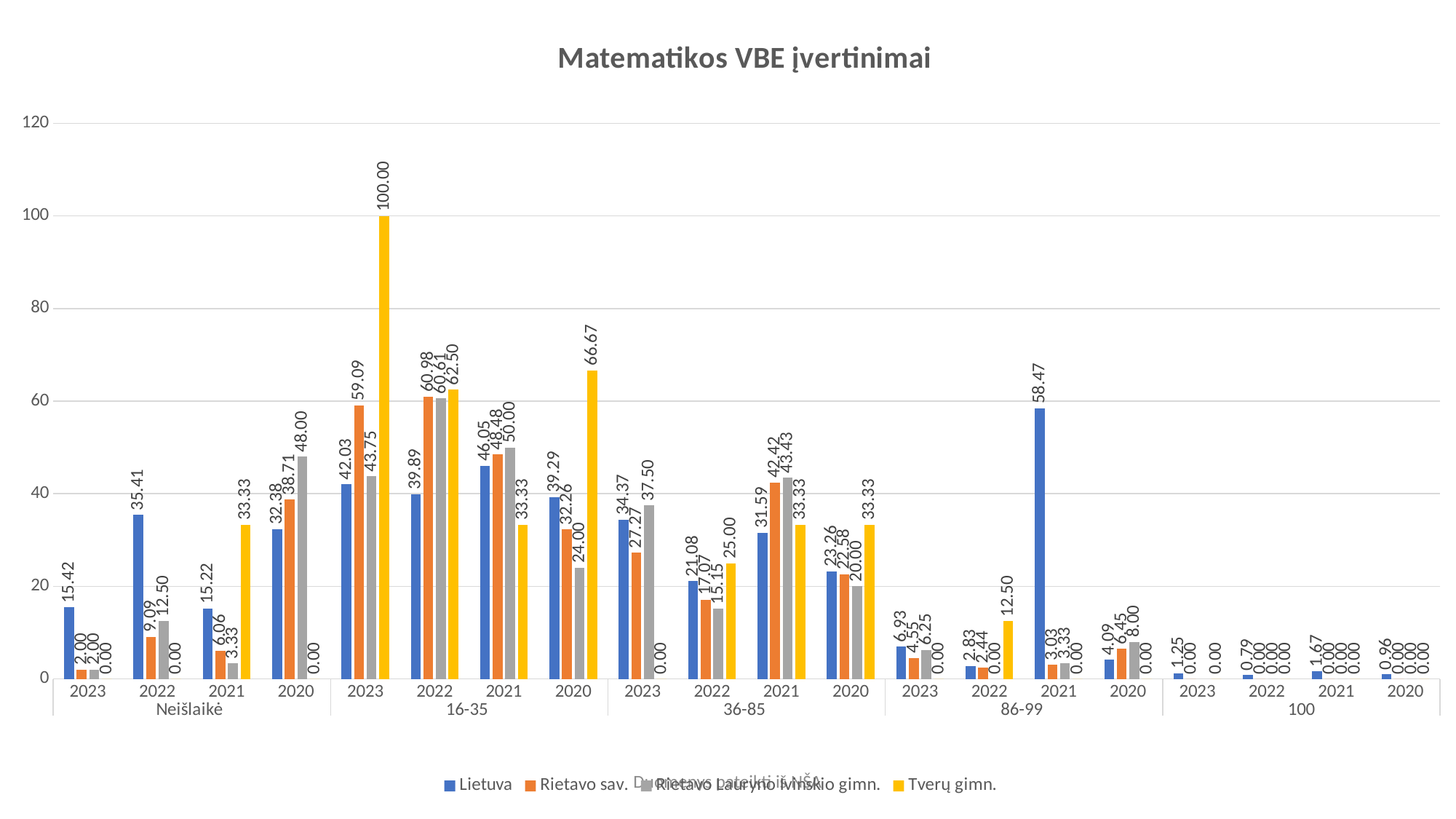
What is the value for Lietuva in the 16-35 category for 2023? 42.03 What is the value for Rietavo sav. in the 36-85 category for 2021? 42.42 How many series does the legend list? 4 What is the difference between the Lietuva values for 2022 and 2023 in the Neišlaikė category? 19.99 What is the value for Tverų gimn. in the 16-35 category for 2023? 100.00 What is the value for Lietuva in the 86-99 category for 2021? 58.47 What kind of chart is shown on the slide? bar chart In the Neišlaikė category for 2020, which is larger: Lietuva or Rietavo sav.? Rietavo sav. Which series and year has the highest bar in the whole chart? Tverų gimn., 2023 (16-35) Is the value for Tverų gimn. in the 16-35 category for 2020 greater or less than 60? greater What is the title of the chart? Matematikos VBE įvertinimai How many score categories are shown along the x axis? 5